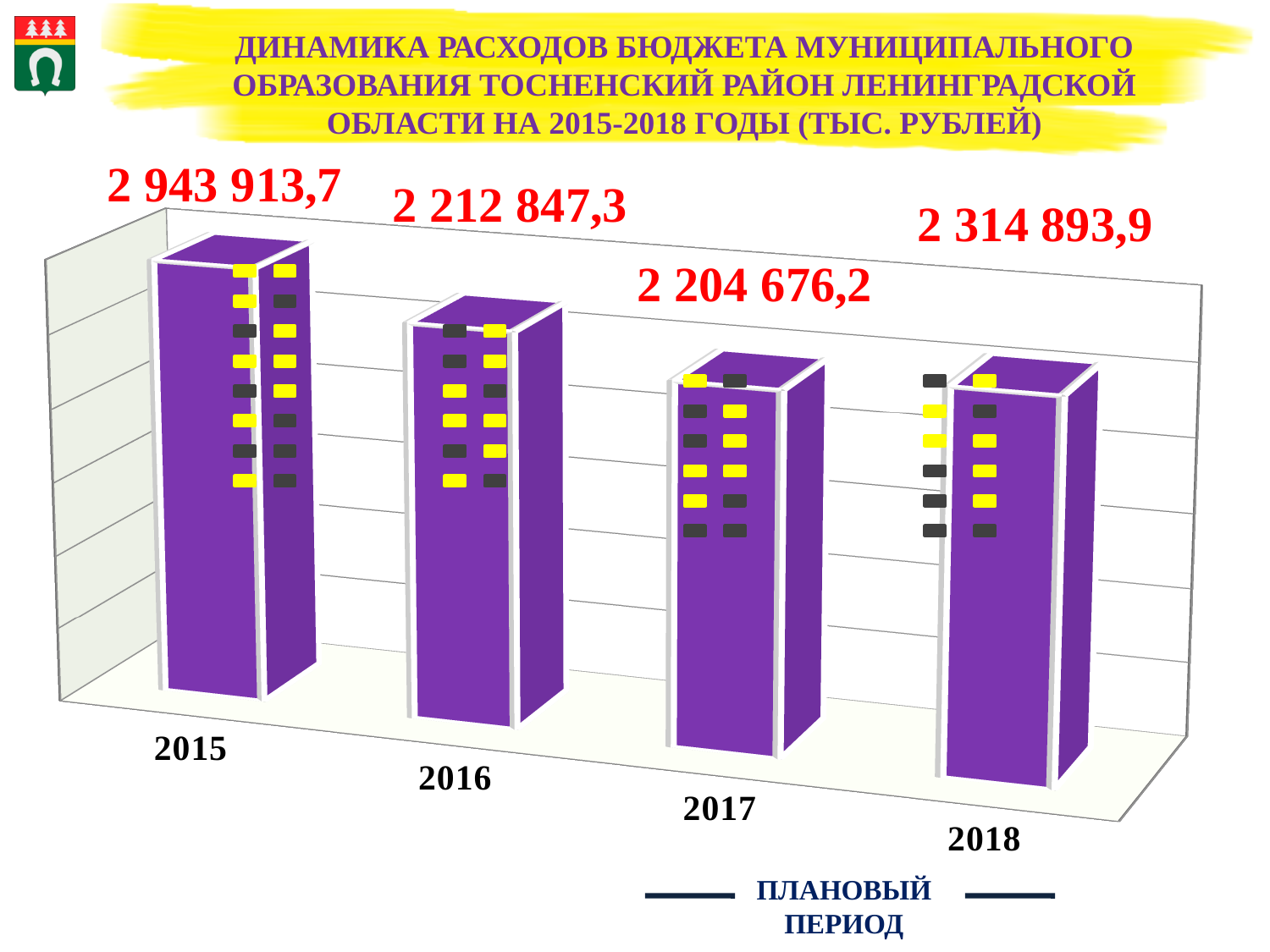
What kind of chart is shown on the slide? Bar chart What is the difference between the values for 2015 and 2016? 731 066,4 What is the value shown for 2016? 2 212 847,3 What is the value shown for 2018? 2 314 893,9 What is the value shown for 2017? 2 204 676,2 Which year has the lowest budget expenditure? 2017 How many years are shown on the chart? 4 Which year has the larger value, 2016 or 2018? 2018 Which year has the highest budget expenditure? 2015 What is the budget expenditure value shown for 2015? 2 943 913,7 Do the values rise or fall from 2015 to 2017? Fall What is the difference between the values for 2018 and 2017? 110 217,7